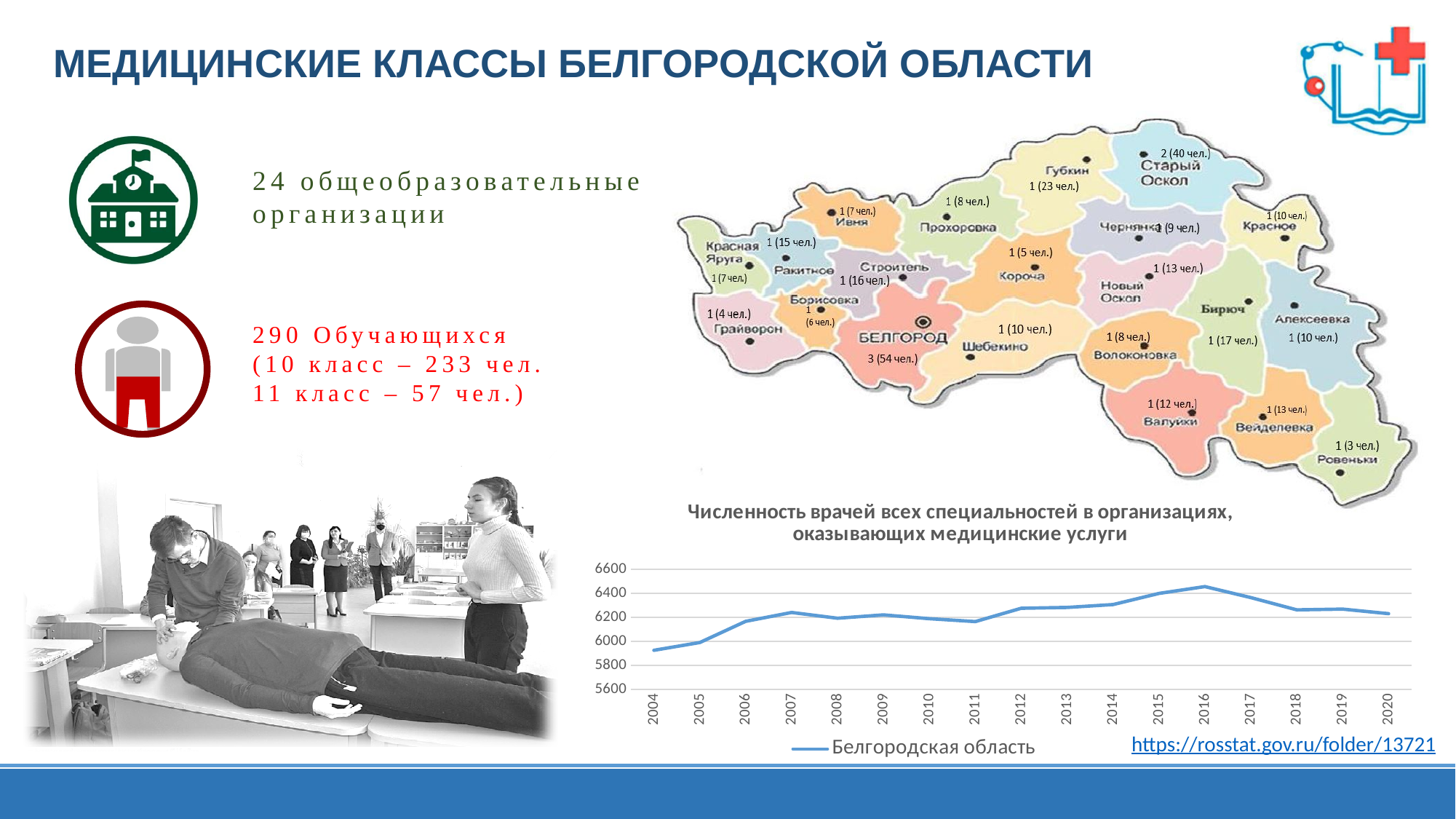
How many years are plotted along the x axis of the line chart? 17 On the line chart, which year has the larger value, 2016 or 2020? 2016 Is the value for 2004 on the line chart greater or less than 6000? less Is the value for 2016 on the line chart greater or less than 6400? greater How many series does the legend of the line chart list? 1 Do the values on the line chart rise or fall from 2016 to 2020? fall What kind of chart is shown at the bottom right of the slide? line chart What is the title of the line chart on the slide? Численность врачей всех специальностей в организациях, оказывающих медицинские услуги Is the value for 2020 on the line chart greater or less than 6400? less In which year does the line chart show its lowest value? 2004 In which year does the line chart reach its highest value? 2016 What is the name of the series shown in the legend of the line chart? Белгородская область